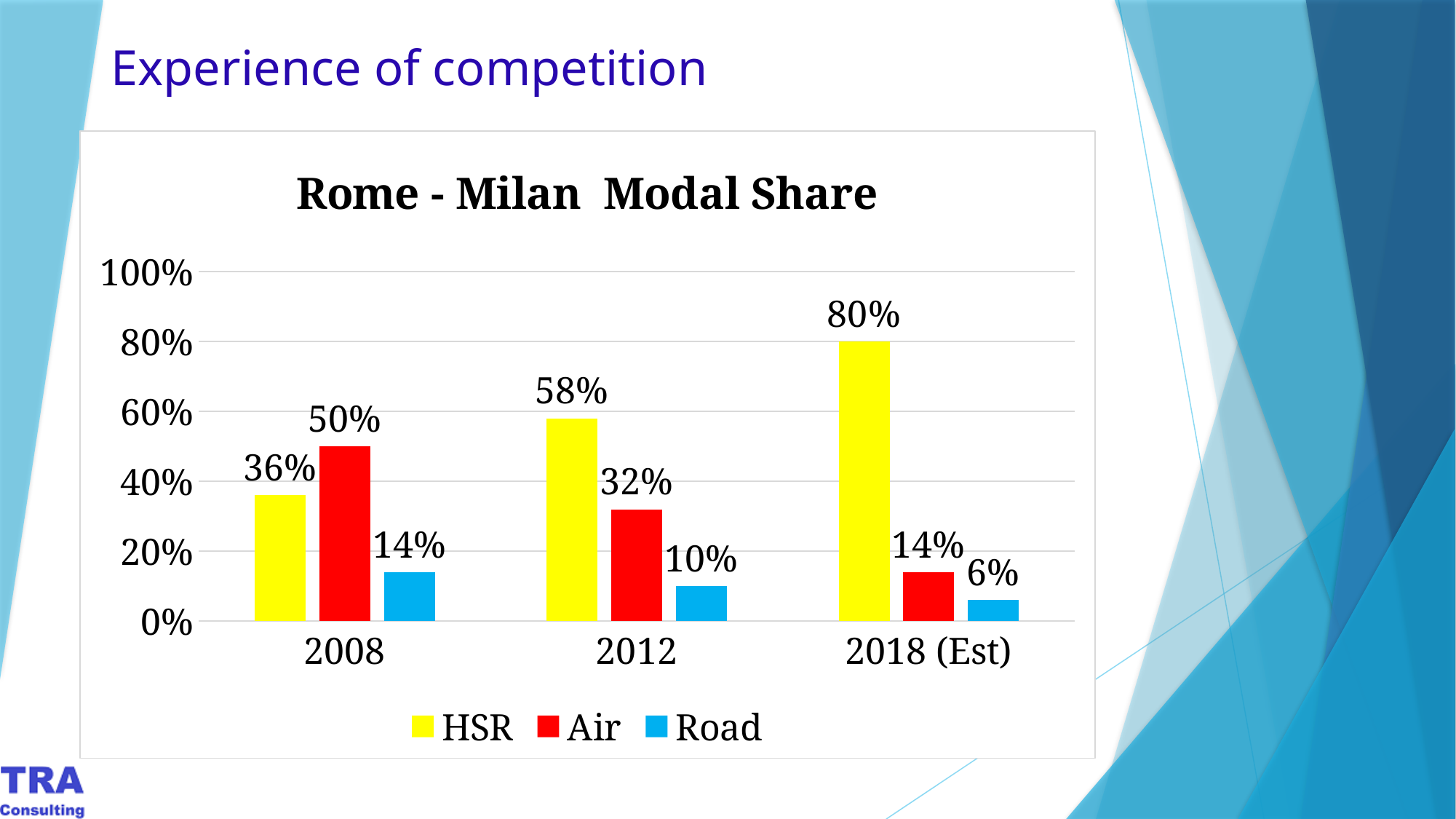
What kind of chart is shown? Bar chart What is the difference between the HSR share and the Air share in 2018 (Est)? 66% Is the HSR share in 2012 greater or less than 40%? greater Which mode has the lowest share in 2012? Road What is the Air modal share in 2008? 50% How many years are shown on the x axis? 3 Does the Air share rise or fall from 2008 to 2018 (Est)? Fall Which year has the highest HSR share? 2018 (Est) In 2008, which is larger: the HSR share or the Air share? Air What is the HSR modal share in 2012? 58% How many series does the legend list? 3 What is the Road modal share in 2018 (Est)? 6%